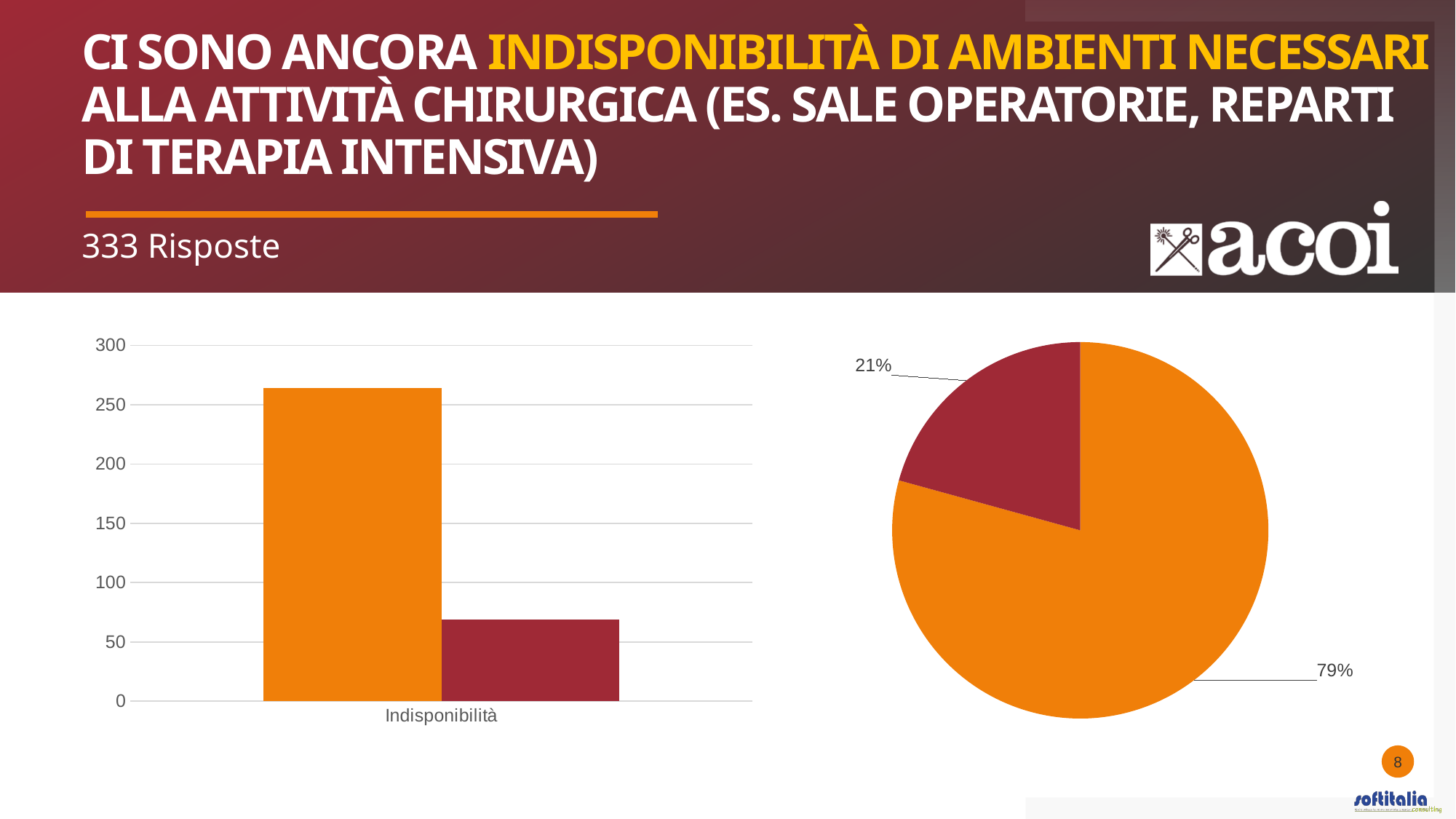
In the bar chart on the left, how many bars are plotted? 2 In the bar chart on the left, is the value of the orange bar greater or less than 250? greater In the pie chart on the right, what is the difference in percentage points between the orange slice and the red slice? 58% In the bar chart on the left, is the value of the red bar greater or less than 100? less In the pie chart on the right, what share does the red slice represent? 21% What kind of chart is shown on the right side of the slide? pie chart In the pie chart on the right, how many slices are there? 2 In the bar chart on the left, what is the category label shown on the x axis? Indisponibilità In the pie chart on the right, what share does the orange slice represent? 79% In the bar chart on the left, which bar is taller, the orange bar or the red bar? the orange bar In the bar chart on the left, is the value of the red bar greater or less than 50? greater What kind of chart is shown on the left side of the slide? bar chart